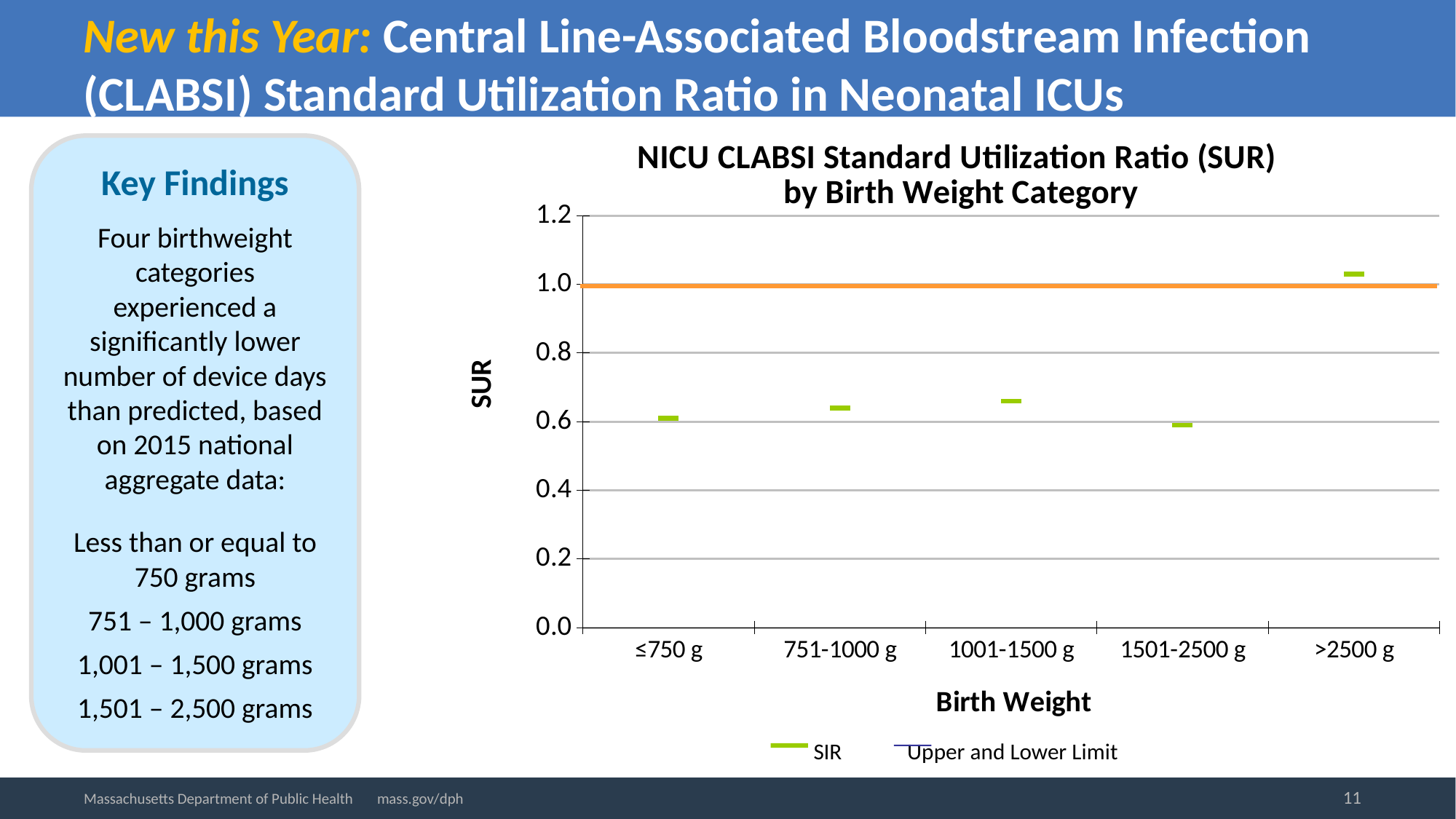
Which birth weight category has the highest SIR value in the chart? >2500 g How many series does the chart legend list? 2 Which has the larger SIR value, 1001-1500 g or >2500 g? >2500 g What is the label of the x axis of the chart? Birth Weight Which has the larger SIR value, 1501-2500 g or >2500 g? >2500 g What is the label of the y axis of the chart? SUR Is the SIR value for ≤750 g greater or less than 0.8? less Is the SIR value for >2500 g greater or less than 0.8? greater Is the SIR value for 751-1000 g greater or less than 0.4? greater How many birth weight categories are shown on the x axis of the chart? 5 What is the title of the chart? NICU CLABSI Standard Utilization Ratio (SUR) by Birth Weight Category